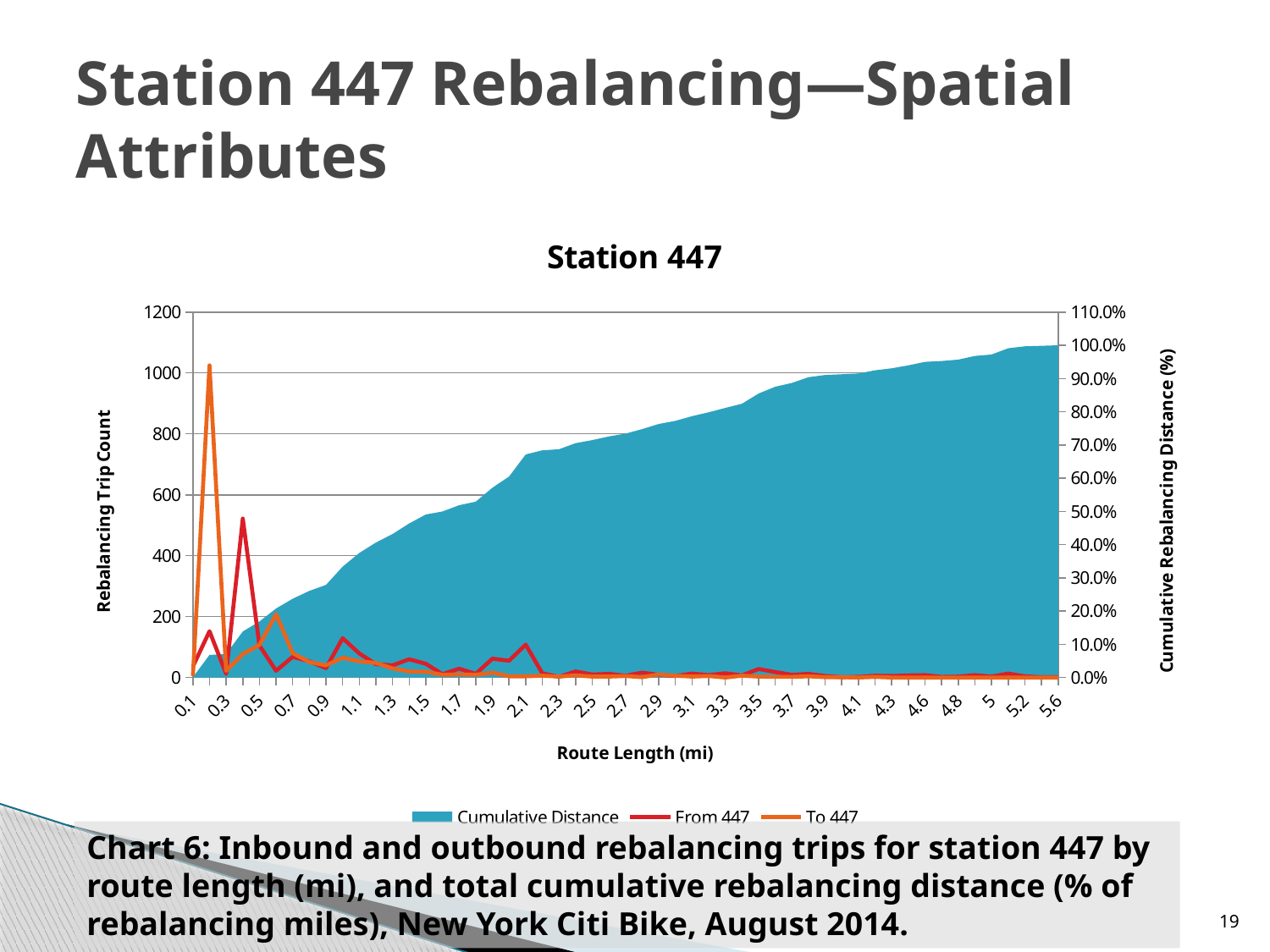
Which series reaches the highest peak value on the chart, From 447 or To 447? To 447 Is the peak value of the To 447 series greater or less than 800? greater What is the title of the chart? Station 447 What is the label of the left vertical axis? Rebalancing Trip Count What are the three series named in the legend? Cumulative Distance, From 447, To 447 Is the peak value of the From 447 series greater or less than 400? greater What is the label of the x axis? Route Length (mi) How many series does the chart legend list? 3 Is the Cumulative Distance value at route length 5.6 greater or less than 90.0%? greater What is the label of the right vertical axis? Cumulative Rebalancing Distance (%) What is the highest tick value shown on the left vertical axis? 1200 Does the Cumulative Distance series rise or fall as route length increases? rise